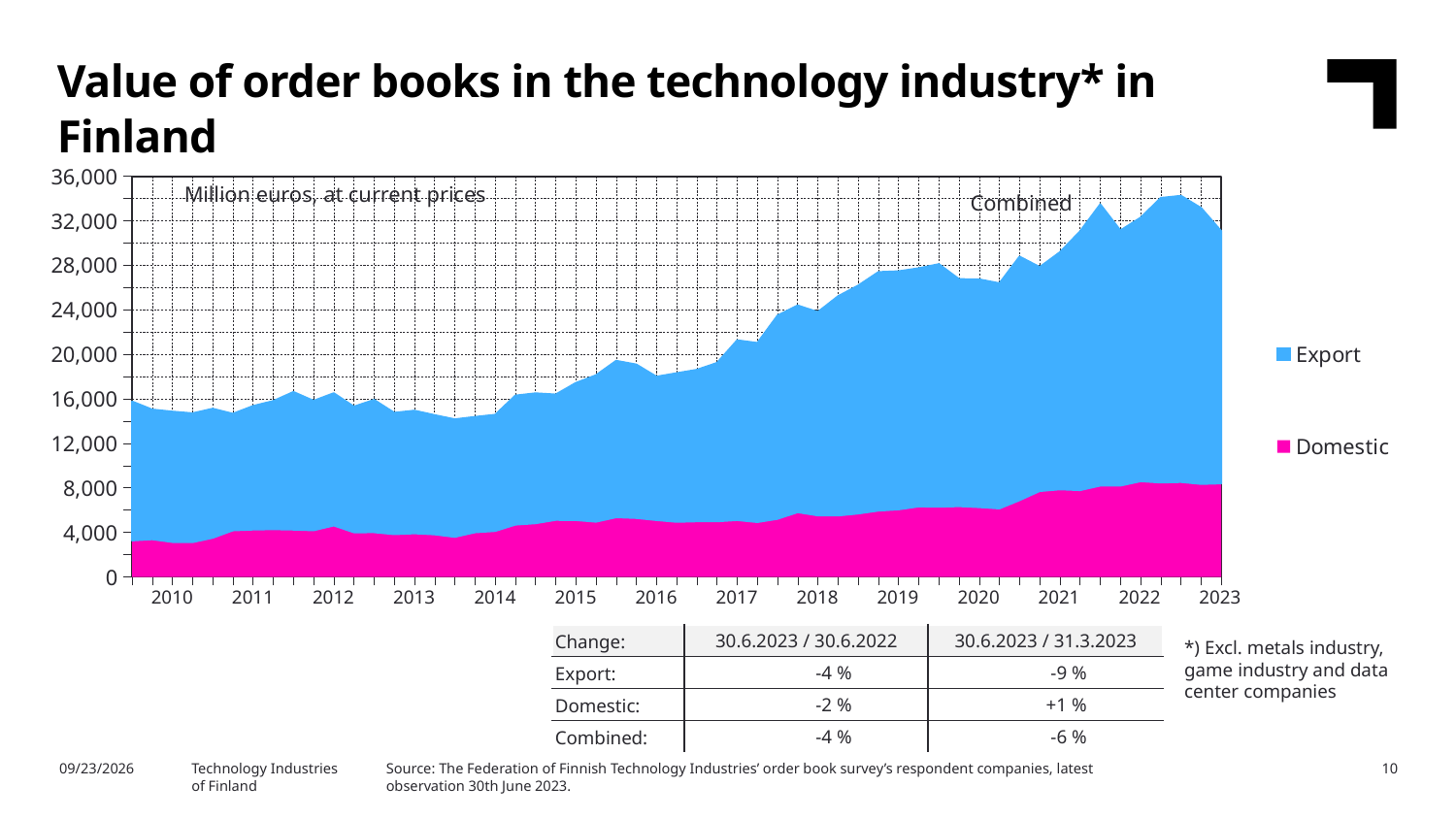
How many years are labeled on the x axis of the chart? 14 What type of chart is shown on the slide? Area chart In what unit are the values in the chart expressed, according to the label inside the plot area? Million euros, at current prices Which two series are listed in the chart legend? Export and Domestic Is the Domestic value in 2022 greater or less than 4,000? greater How many series does the chart legend list? 2 Is the combined value of order books at the start of 2010 greater or less than 20,000? less Is the combined value of order books in 2023 greater or less than 28,000? greater Does the combined value generally rise or fall between 2016 and 2019? rise Does the Domestic series generally rise or fall from 2010 to 2023? rise Which series is larger in 2023, Export or Domestic? Export